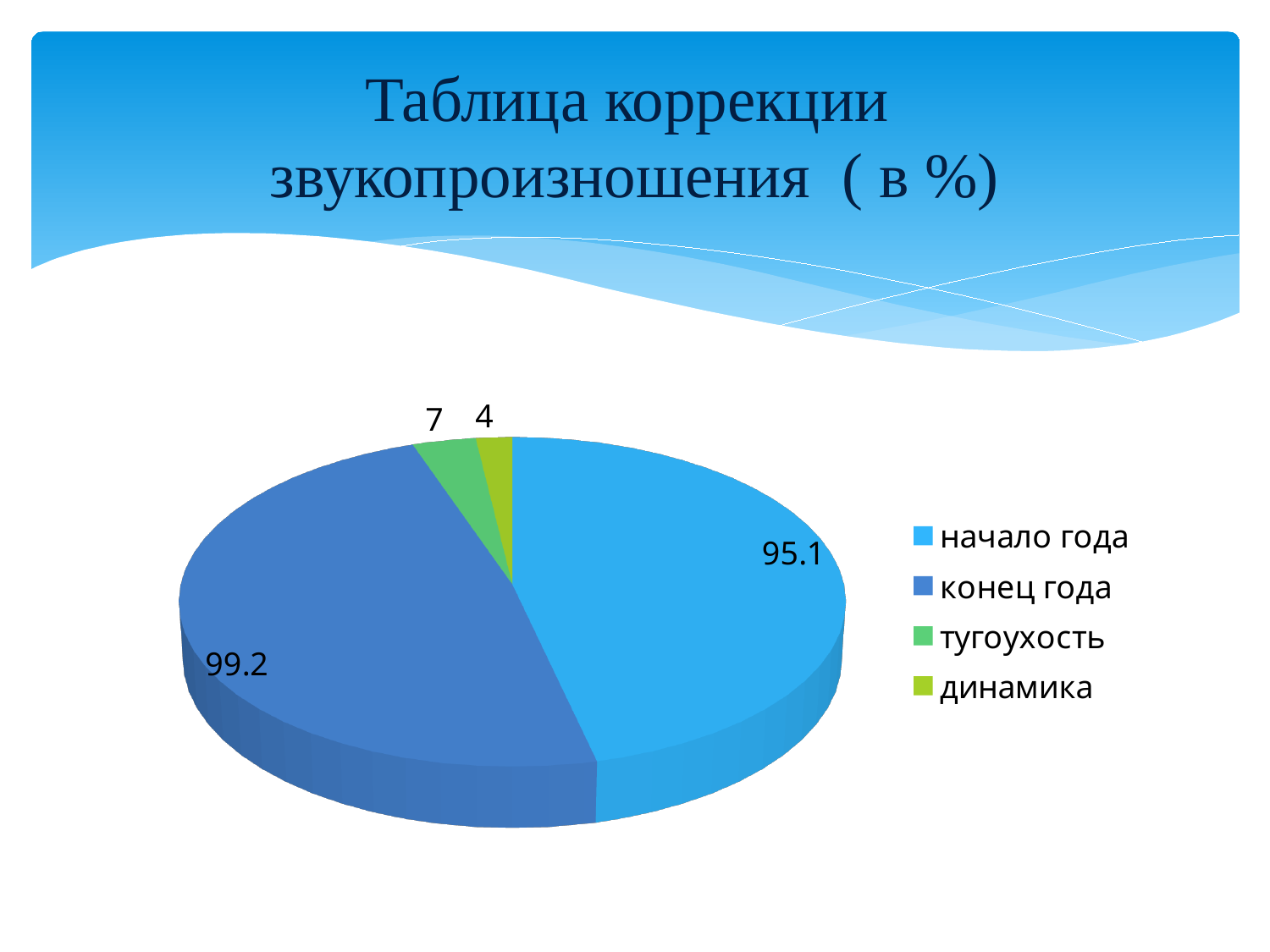
How many categories does the legend list? 4 What is the value for тугоухость? 7 What is the difference between the values for тугоухость and динамика? 3 Which category has the smallest slice of the pie? динамика What is the value for динамика? 4 What type of chart is shown on the slide? pie chart What is the value for конец года? 99.2 Which category has the largest slice of the pie? конец года Which is larger, the value for начало года or the value for тугоухость? начало года What is the title of the chart slide? Таблица коррекции звукопроизношения ( в %) What is the difference between the values for конец года and начало года? 4.1 What is the value for начало года? 95.1